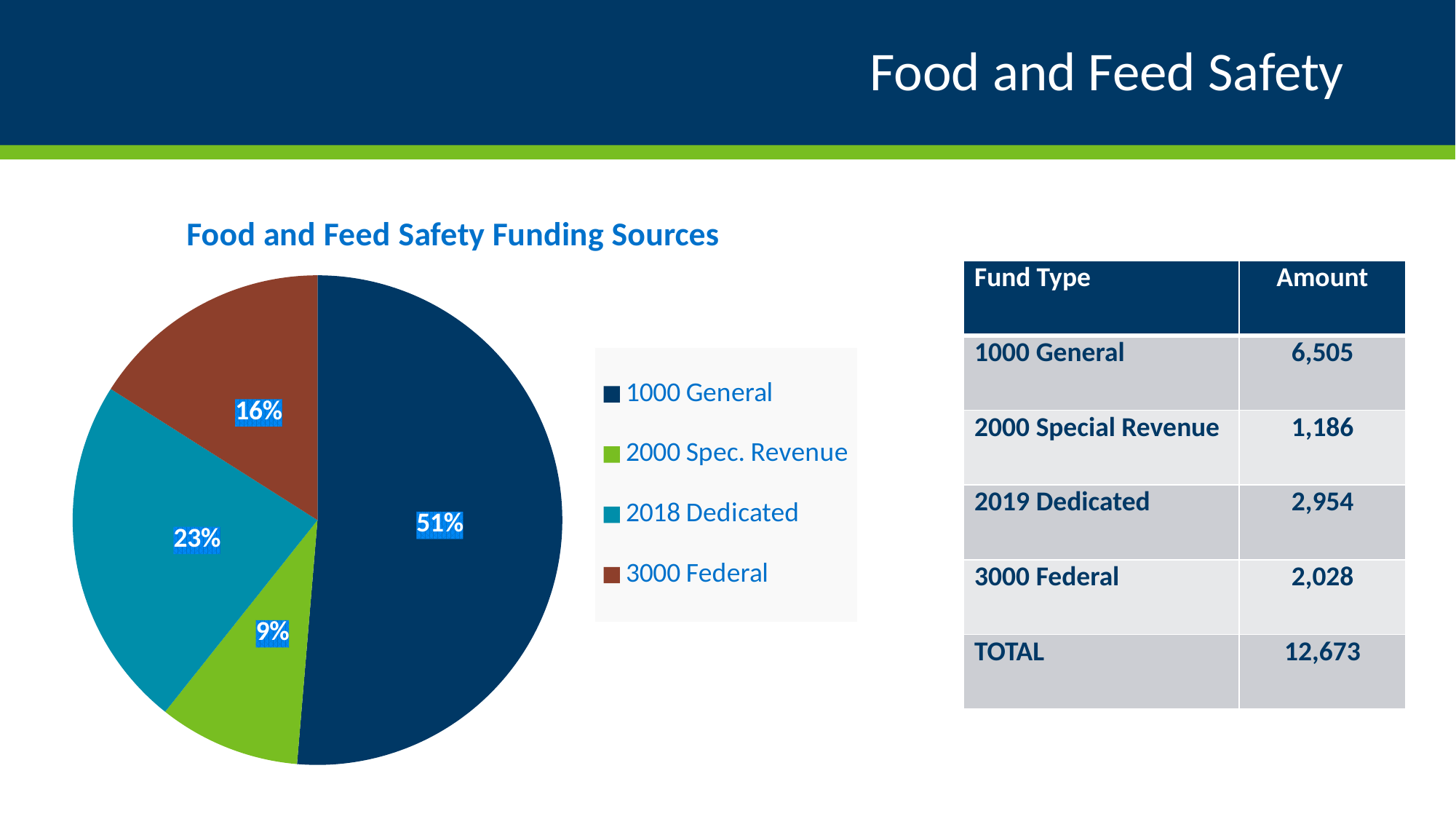
What share of the pie does 1000 General represent? 51% What percentage is shown for 2000 Spec. Revenue in the pie chart? 9% Which funding source has the largest slice of the pie? 1000 General Which slice is larger, 3000 Federal or 2000 Spec. Revenue? 3000 Federal What is the difference in percentage points between the 2018 Dedicated slice and the 3000 Federal slice? 7 What percentage is shown for 2018 Dedicated in the pie chart? 23% Which funding source has the smallest slice of the pie? 2000 Spec. Revenue How many slices does the pie chart have? 4 What kind of chart is shown on the slide? Pie chart What percentage is shown for 3000 Federal in the pie chart? 16% What is the title of the chart? Food and Feed Safety Funding Sources Which legend entry is shown in green? 2000 Spec. Revenue